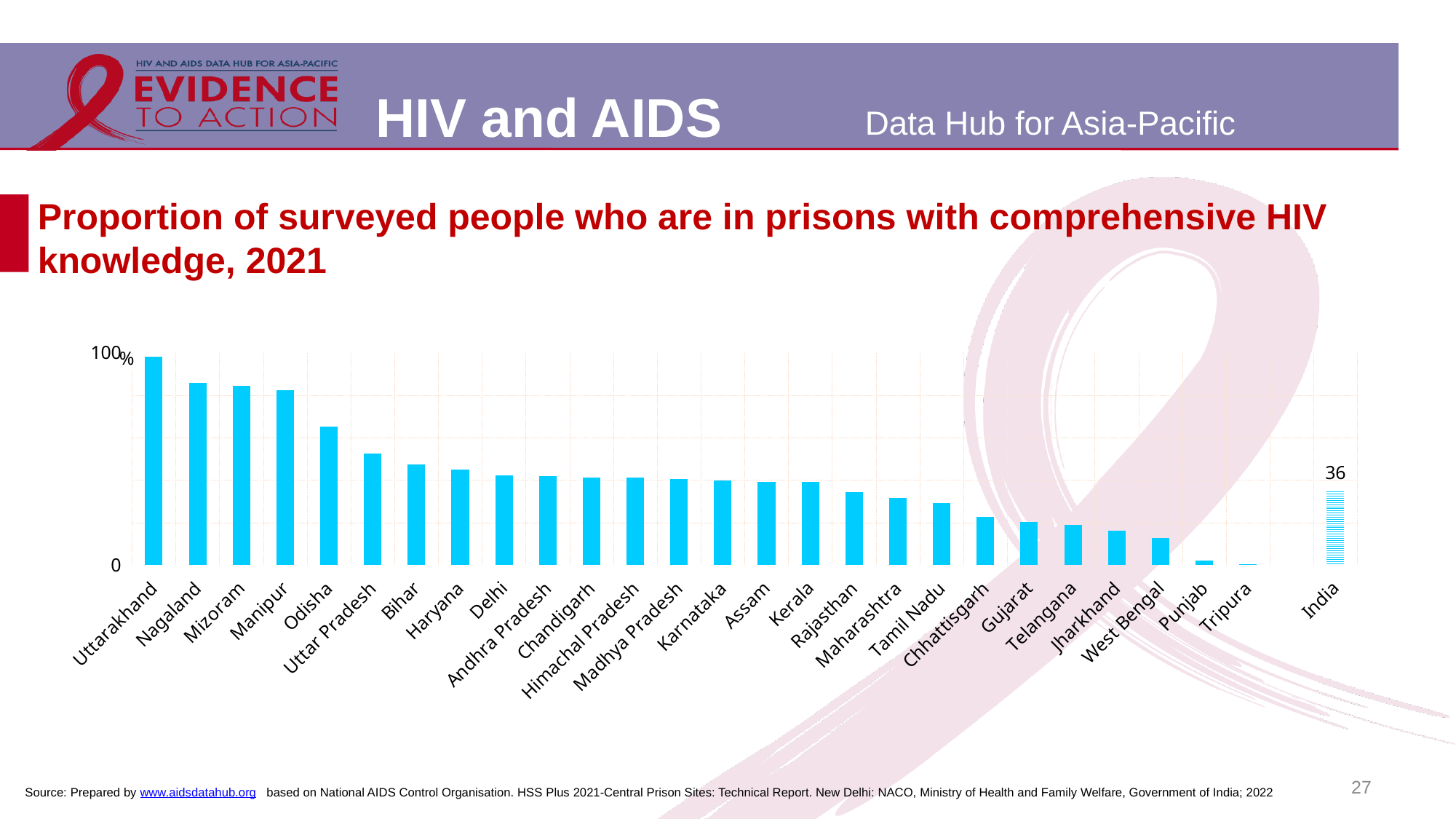
How many bars (categories) are plotted in the chart, including India? 27 Do the values for the states generally rise or fall from left to right along the x axis? Fall What type of chart is shown on the slide? Bar chart Which state has the lowest proportion of surveyed people in prisons with comprehensive HIV knowledge? Tripura Which state has the highest proportion of surveyed people in prisons with comprehensive HIV knowledge? Uttarakhand What is the maximum value shown on the y axis? 100% What is the value shown for India? 36 Which has a higher value, Punjab or Nagaland? Nagaland Which has a higher value, West Bengal or Uttar Pradesh? Uttar Pradesh What year does the chart title refer to? 2021 Which has a higher value, Odisha or Gujarat? Odisha